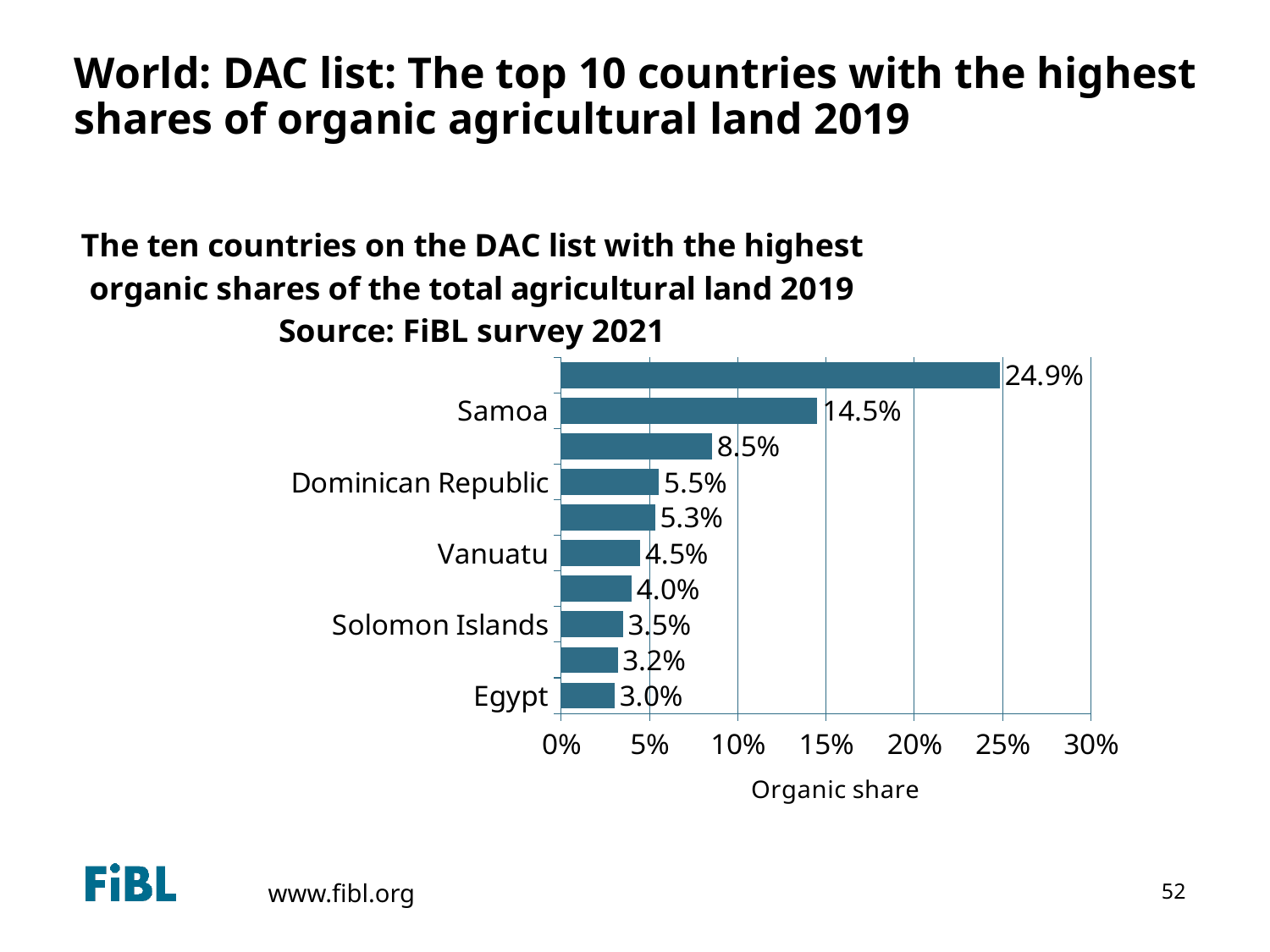
What is the value of the longest bar in the chart? 24.9% What is the organic share for Vanuatu? 4.5% Which has a larger organic share, Vanuatu or the Solomon Islands? Vanuatu What is the organic share for the Solomon Islands? 3.5% How many bars are shown in the chart? 10 Is the organic share for Samoa greater or less than 10%? greater What is the organic share for Egypt? 3.0% What is the organic share for the Dominican Republic? 5.5% What kind of chart is shown on the slide? Bar chart Which labelled country has the lowest organic share in the chart? Egypt What is the organic share for Samoa? 14.5% What is the difference between the organic shares of Samoa and the Dominican Republic? 9.0%